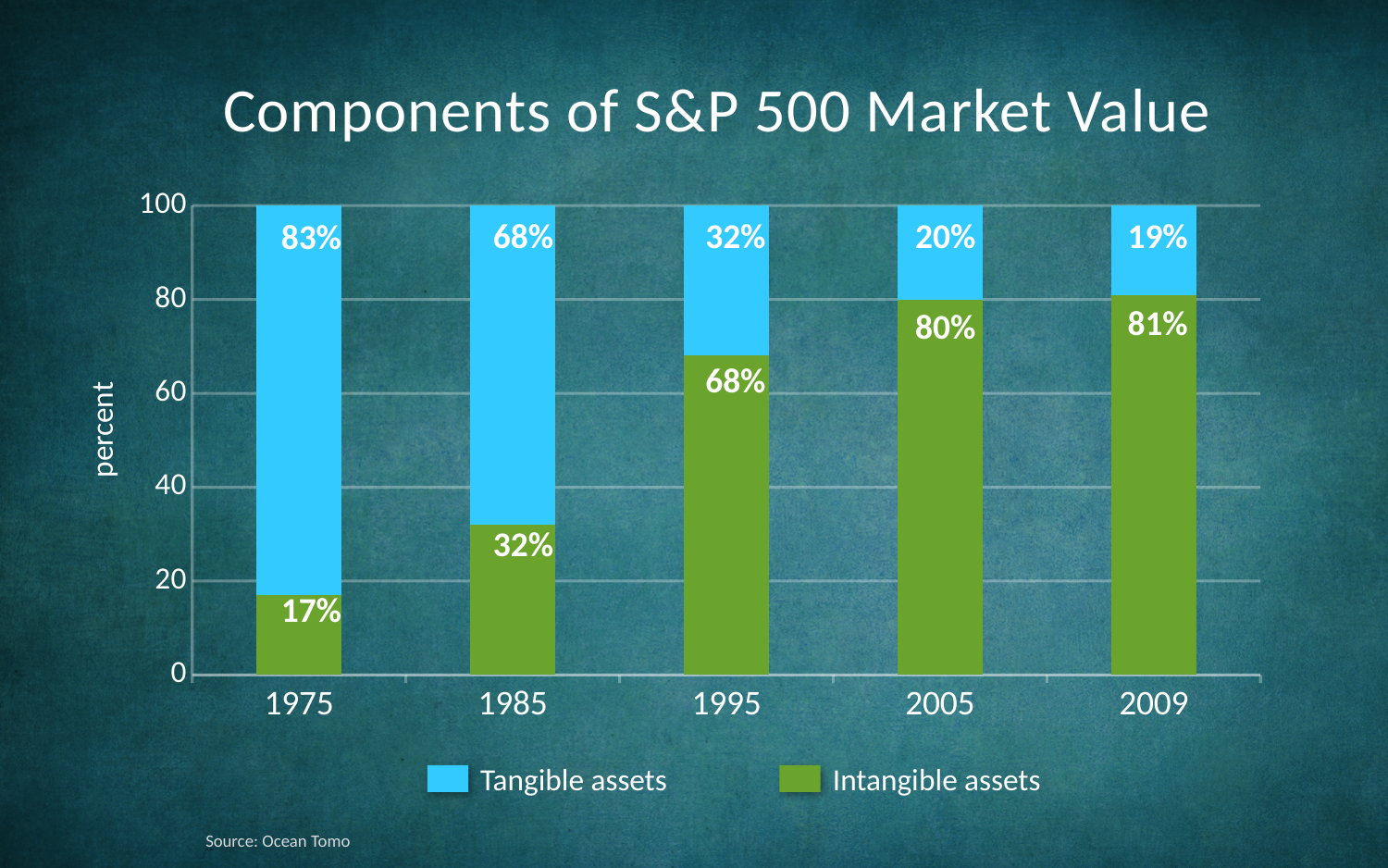
Does the Intangible assets value rise or fall from 1975 to 2009? Rise In which year is the Tangible assets value highest? 1975 What is the value for Intangible assets in 1975? 17% What kind of chart is shown? Stacked bar chart How many years are shown on the x axis? 5 How many series does the legend list? 2 What is the difference between the Tangible assets value in 1975 and in 2009? 64% In which year is the Intangible assets value lowest? 1975 Which is larger in 1995, Tangible assets or Intangible assets? Intangible assets What is the value for Intangible assets in 2009? 81% What is the value for Tangible assets in 1985? 68% What is the value for Tangible assets in 2005? 20%